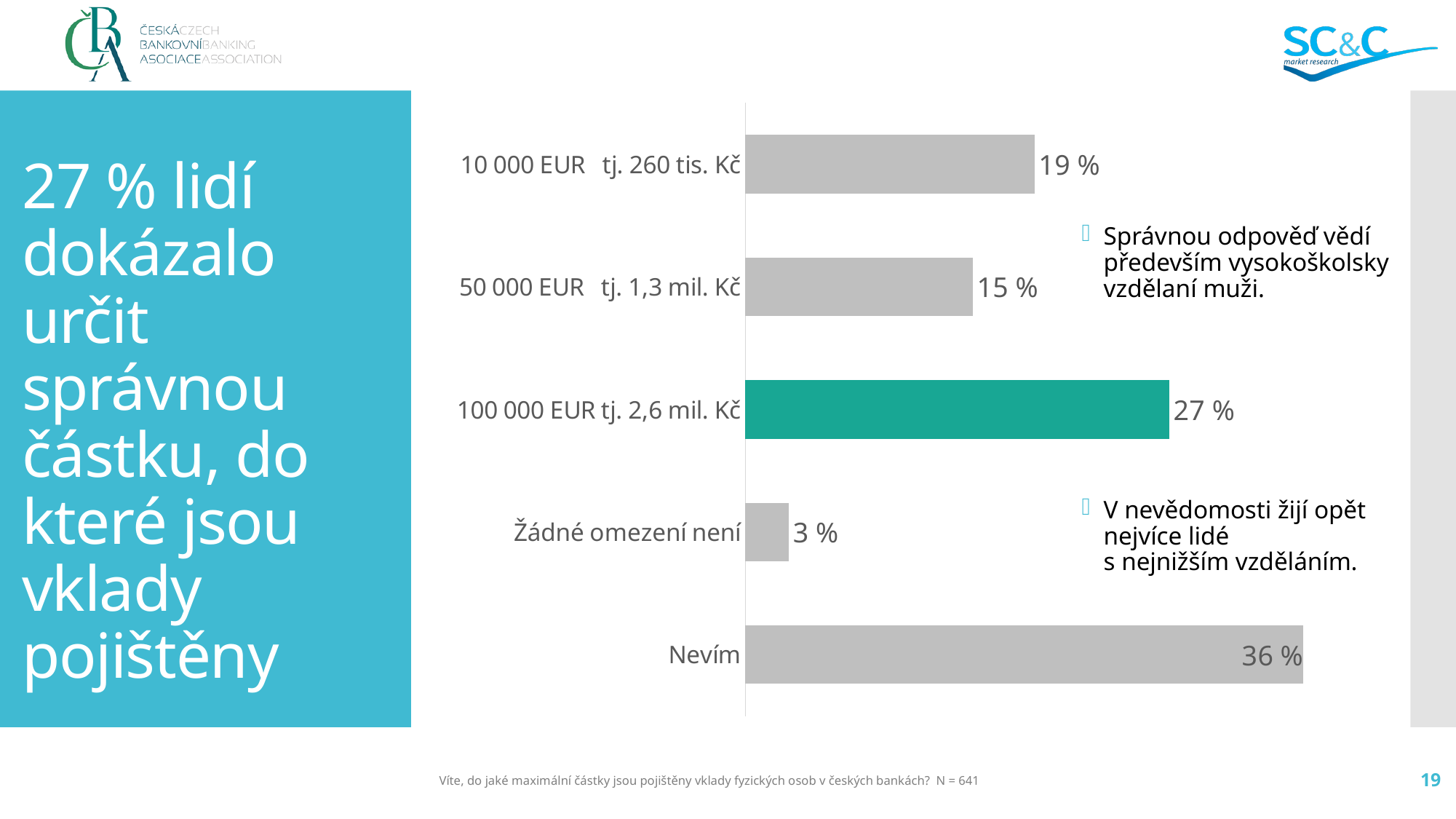
What is the difference between the values for "50 000 EUR tj. 1,3 mil. Kč" and "Žádné omezení není"? 12 % Which category has the lowest value? Žádné omezení není Which bar is highlighted in a different colour (teal) from the others? 100 000 EUR tj. 2,6 mil. Kč What is the value for "Žádné omezení není"? 3 % How many categories are shown in the chart? 5 Which category has the highest value? Nevím What is the difference between the values for "Nevím" and "100 000 EUR tj. 2,6 mil. Kč"? 9 % What is the value for "100 000 EUR tj. 2,6 mil. Kč"? 27 % What kind of chart is shown on the slide? Bar chart What is the value for "Nevím"? 36 % Which is larger: the value for "10 000 EUR tj. 260 tis. Kč" or for "50 000 EUR tj. 1,3 mil. Kč"? 10 000 EUR tj. 260 tis. Kč What is the value for "10 000 EUR tj. 260 tis. Kč"? 19 %